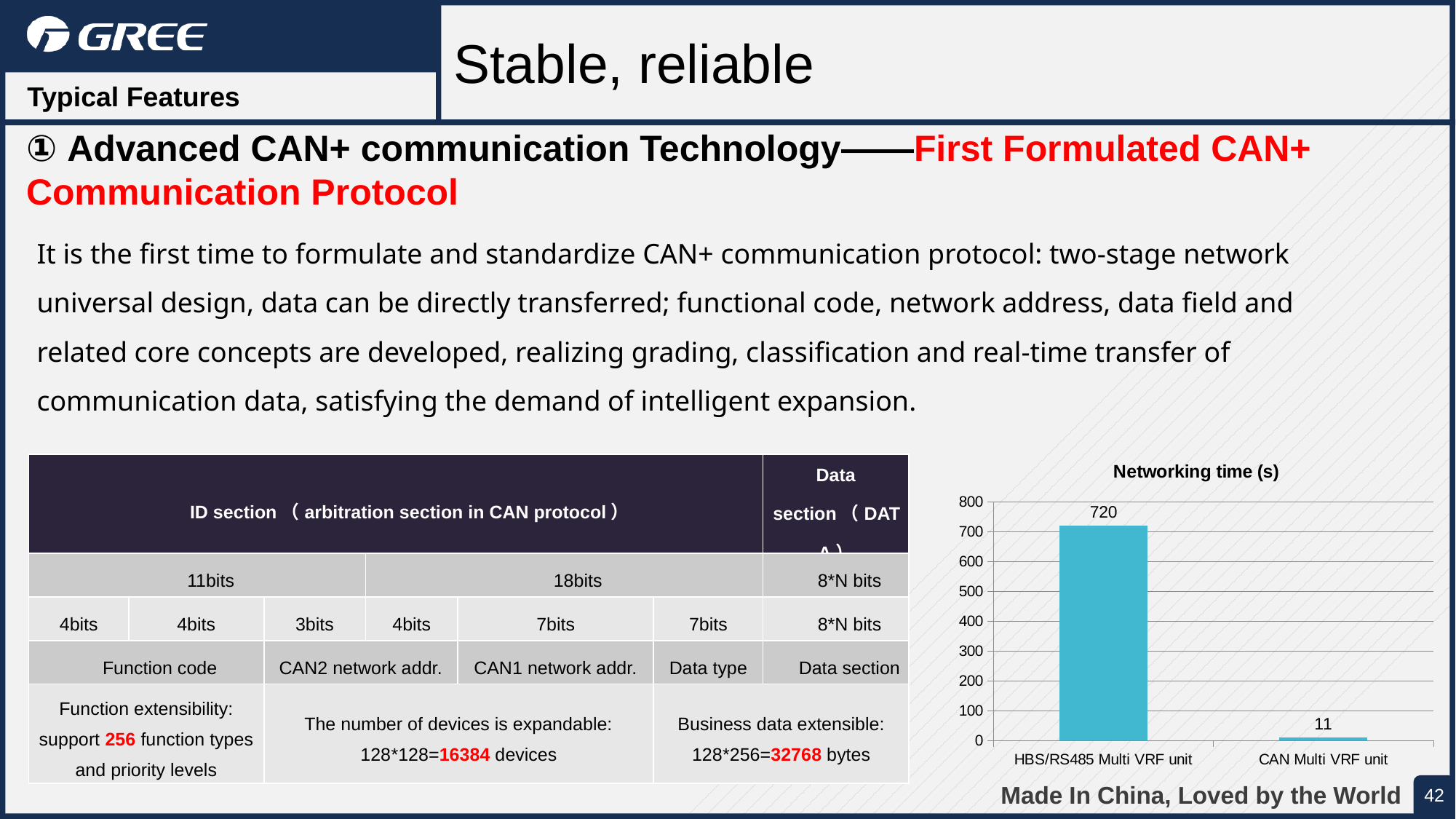
What is the networking time for the HBS/RS485 Multi VRF unit? 720 What is the difference in networking time between the HBS/RS485 Multi VRF unit and the CAN Multi VRF unit? 709 Is the networking time for the HBS/RS485 Multi VRF unit greater or less than 500? greater What is the networking time for the CAN Multi VRF unit? 11 What is the title of the chart? Networking time (s) Is the networking time for the CAN Multi VRF unit greater or less than 100? less What kind of chart is shown on the slide? bar chart How many categories are shown in the chart? 2 Which category has the highest networking time? HBS/RS485 Multi VRF unit Which category has the lowest networking time? CAN Multi VRF unit What is the maximum value shown on the chart's vertical axis? 800 Which has a larger networking time, the HBS/RS485 Multi VRF unit or the CAN Multi VRF unit? HBS/RS485 Multi VRF unit